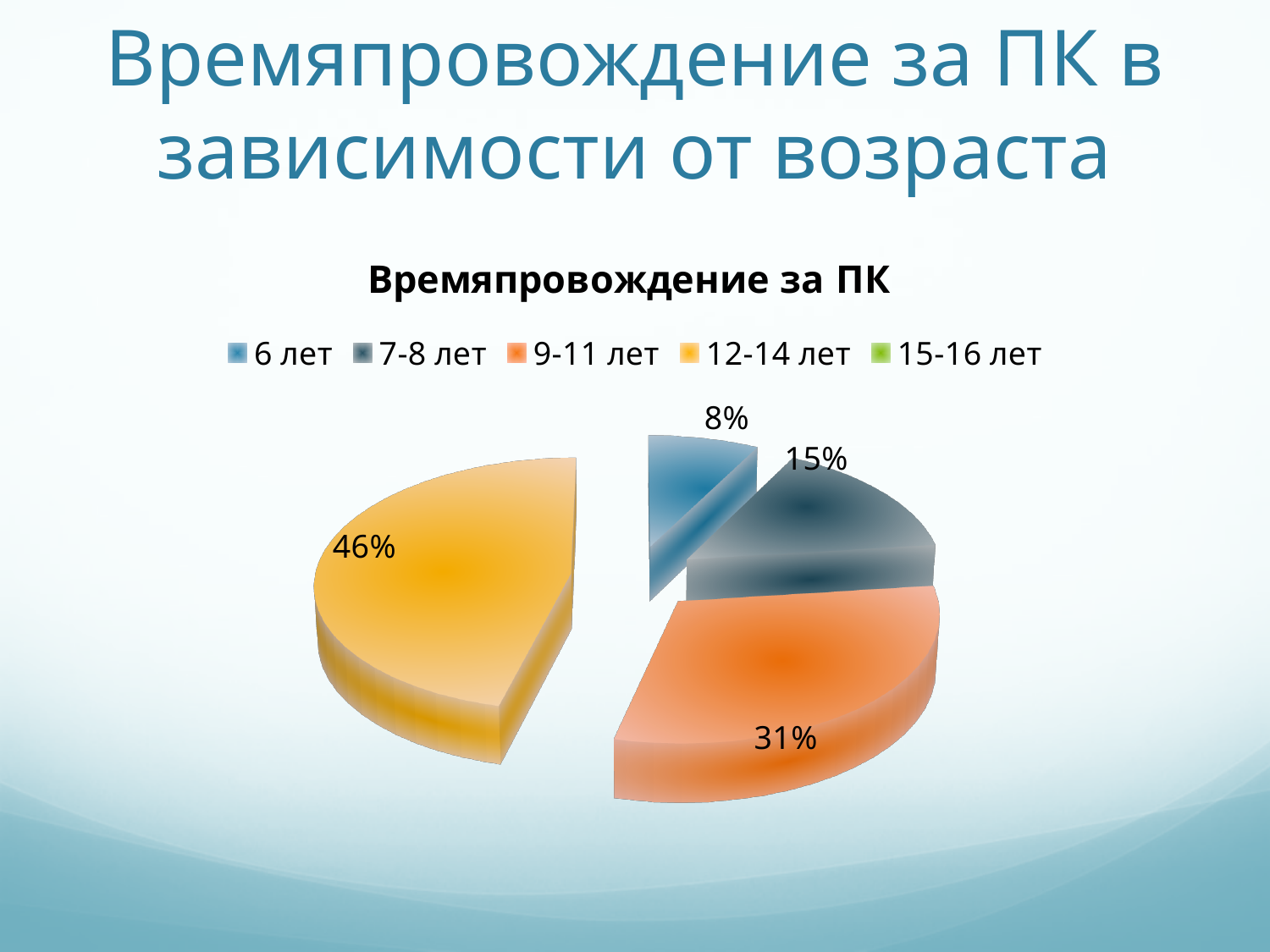
What share of the pie does the 9-11 лет slice have? 31% What type of chart is shown on the slide? Pie chart What share of the pie does the 7-8 лет slice have? 15% Which age group has the largest slice of the pie? 12-14 лет What is the title of the chart? Времяпровождение за ПК How many entries does the chart legend list? 5 Which slice is larger, 7-8 лет or 9-11 лет? 9-11 лет What colour is the 12-14 лет slice? Yellow What share of the pie does the 6 лет slice have? 8% Which of the labelled slices is the smallest? 6 лет What is the difference in percentage points between the 12-14 лет slice and the 9-11 лет slice? 15 What share of the pie does the 12-14 лет slice have? 46%